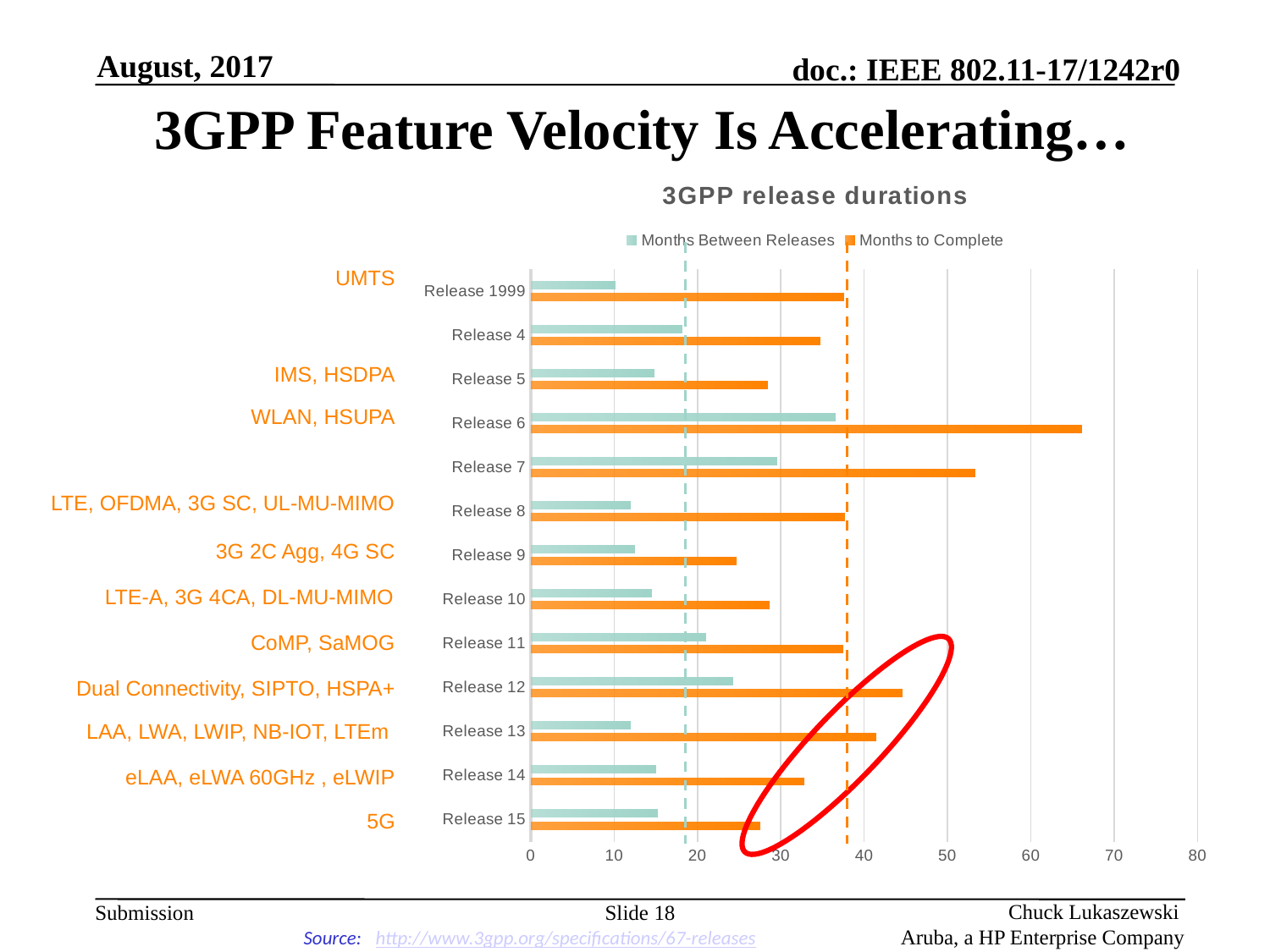
How many releases are plotted on the chart? 13 How many series does the chart's legend list? 2 What kind of chart is shown on the slide? Bar chart Which release has the highest value for Months Between Releases? Release 6 Is the Months Between Releases value for Release 6 greater or less than 30? greater Is the Months to Complete value for Release 7 greater or less than 50? greater Which release has the highest value for Months to Complete? Release 6 Is the Months to Complete value for Release 9 greater or less than 30? less What is the title of the chart? 3GPP release durations Do the Months to Complete values rise or fall from Release 12 to Release 15? fall Which has the larger Months to Complete value, Release 5 or Release 6? Release 6